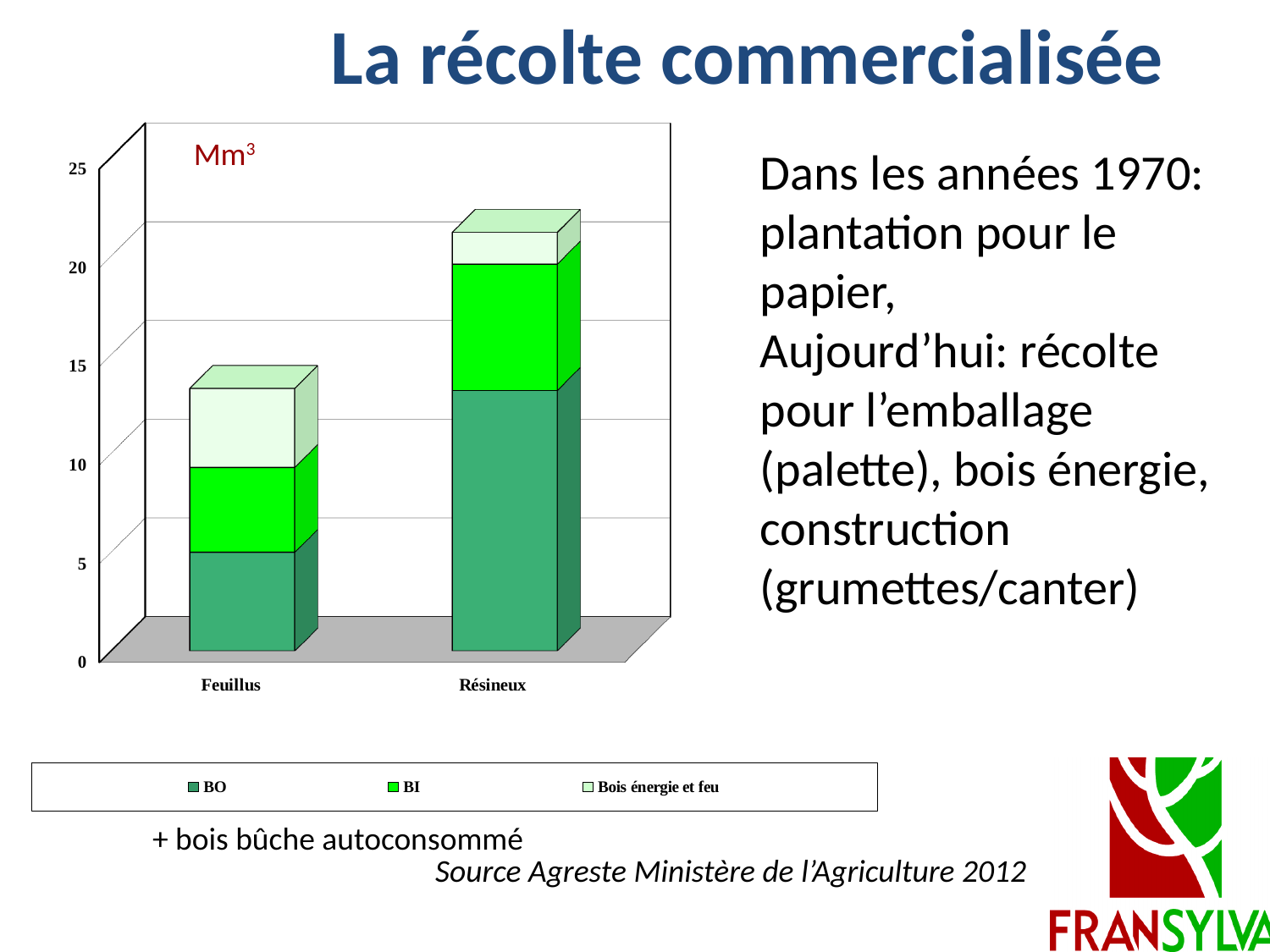
Which category has the taller stacked bar, Feuillus or Résineux? Résineux Is the total height of the Feuillus bar greater or less than 15? less Is the total height of the Résineux bar greater or less than 20? greater Which category has the larger Bois énergie et feu segment, Feuillus or Résineux? Feuillus What unit is indicated at the top of the chart? Mm³ Which category has the larger BO segment, Feuillus or Résineux? Résineux What are the three series names listed in the chart legend? BO, BI, Bois énergie et feu Is the BO value for Résineux greater or less than 10? greater What kind of chart is shown on the slide? Stacked bar chart How many categories are shown on the x axis of the chart? 2 How many series does the chart legend list? 3